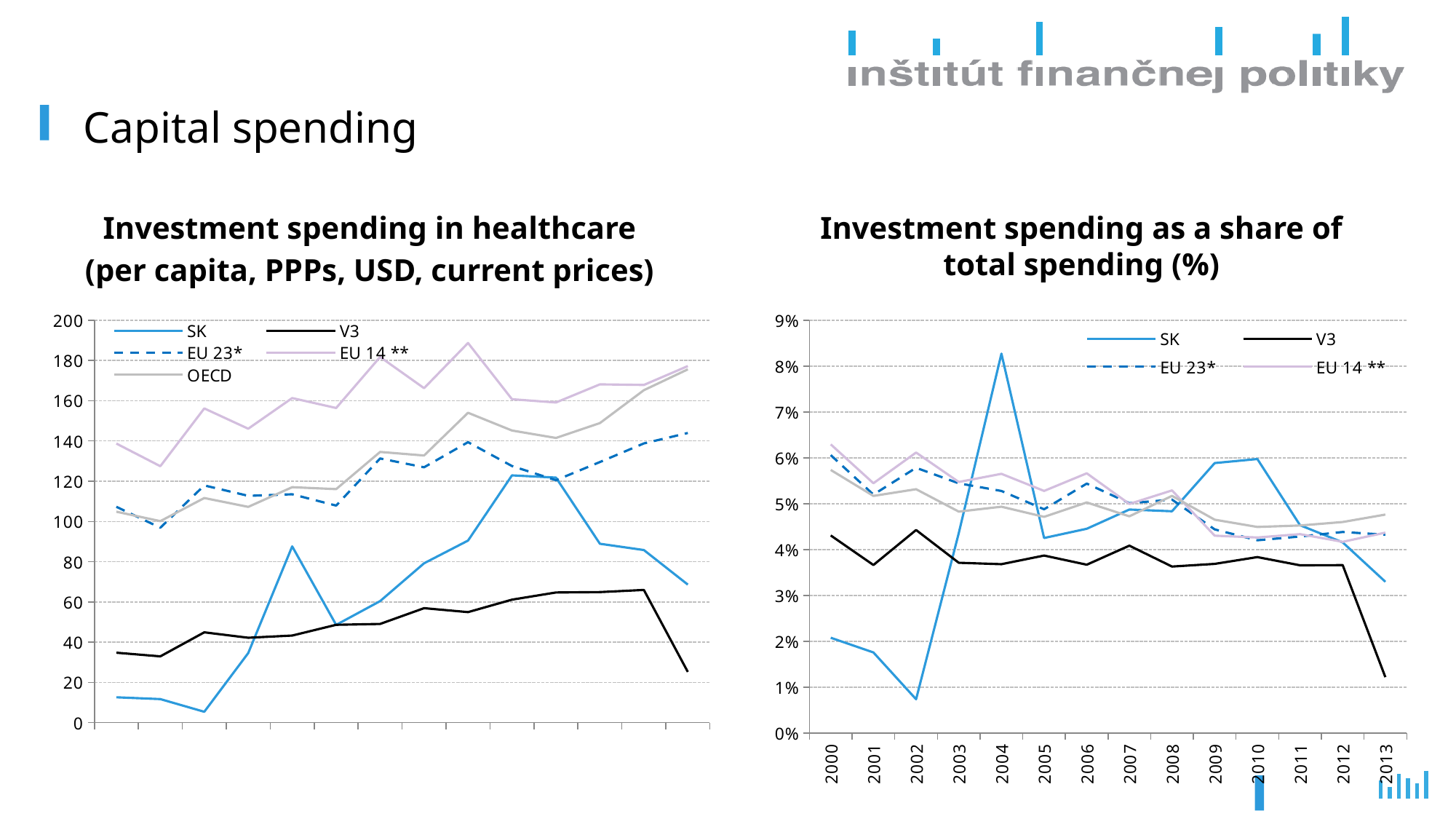
In the right chart ('Investment spending as a share of total spending'), does the V3 series rise or fall between 2012 and 2013? fall In the right chart ('Investment spending as a share of total spending'), which series has the highest value in 2004? SK In the left chart ('Investment spending in healthcare'), is the highest point of the EU 14 ** series greater or less than 180? greater In the left chart ('Investment spending in healthcare'), is the first value of the SK series greater or less than 20? less In the right chart ('Investment spending as a share of total spending'), is the SK value for 2002 greater or less than 1%? less In the right chart ('Investment spending as a share of total spending'), which series has the lowest value in 2013? V3 What kind of chart is the 'Investment spending in healthcare' chart on the left? line chart How many series does the legend of the left chart ('Investment spending in healthcare') list? 5 How many series does the legend of the right chart ('Investment spending as a share of total spending') list? 4 In the right chart ('Investment spending as a share of total spending'), how many years are shown on the x axis? 14